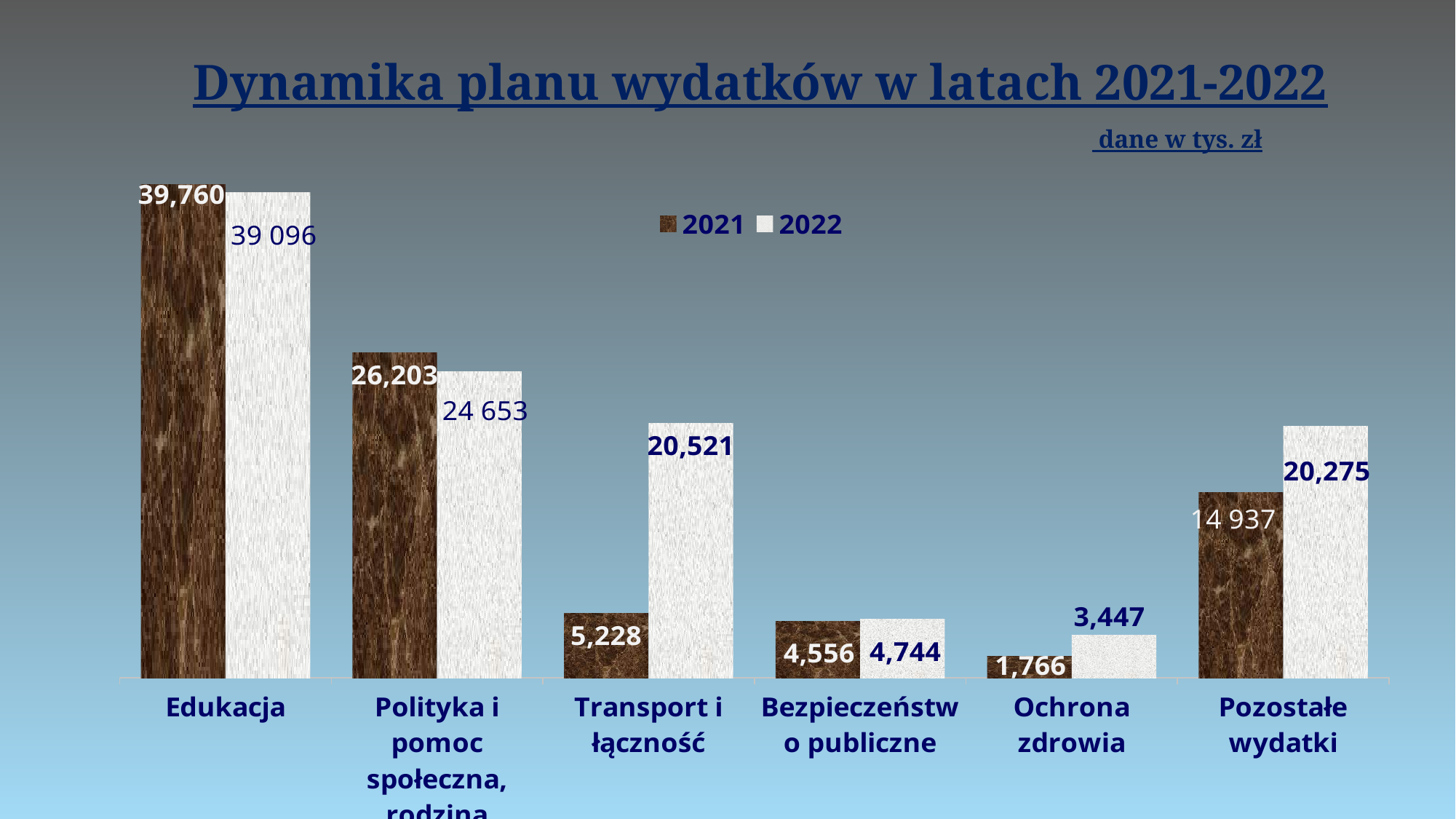
What is the 2021 value for Edukacja? 39,760 Which category has the lowest 2021 value? Ochrona zdrowia What is the title of the chart? Dynamika planu wydatków w latach 2021-2022 What type of chart is shown on the slide? bar chart What is the 2022 value for Pozostałe wydatki? 20,275 Which category has the highest 2022 value? Edukacja How many series does the legend list? 2 What is the difference between the 2022 and 2021 values for Transport i łączność? 15,293 What is the 2022 value for Transport i łączność? 20,521 How many categories are shown on the x axis? 6 What is the 2021 value for Ochrona zdrowia? 1,766 Which is larger for Bezpieczeństwo publiczne: the 2021 value or the 2022 value? 2022